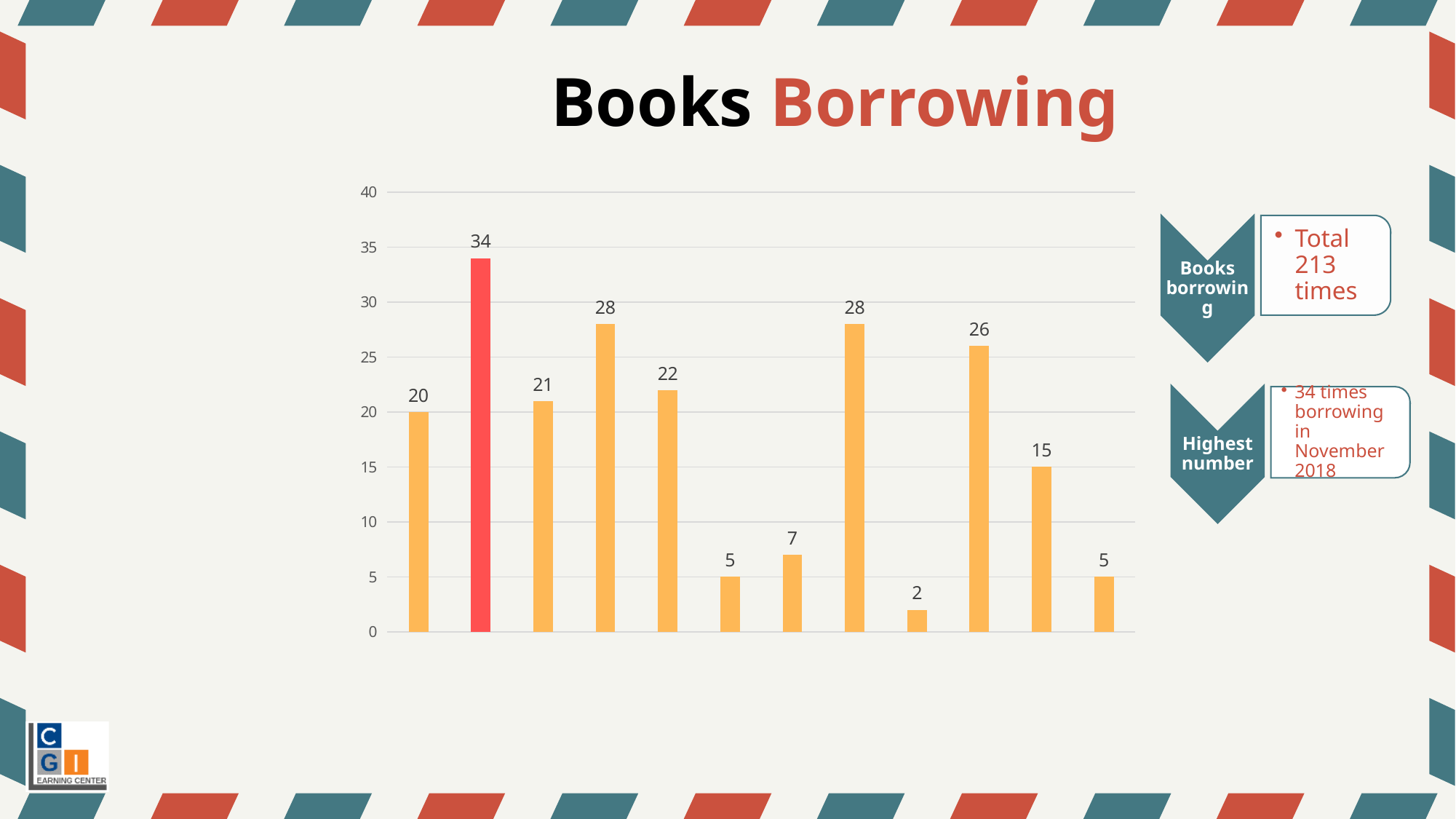
What is the value of the first (leftmost) bar in the chart? 20 What is the value of the last (rightmost) bar in the chart? 5 Which is larger, the third bar from the left or the fifth bar from the left? the fifth bar (22) What is the highest value shown in the chart? 34 What colour is the bar with the highest value in the chart? red What is the difference between the tenth bar (26) and the eleventh bar (15)? 11 What is the title of the slide containing the chart? Books Borrowing How many bars are plotted in the chart? 12 What is the difference between the red bar (34) and the ninth bar (2)? 32 What is the value of the red bar in the chart? 34 What kind of chart is shown on the slide? bar chart What is the lowest value shown in the chart? 2